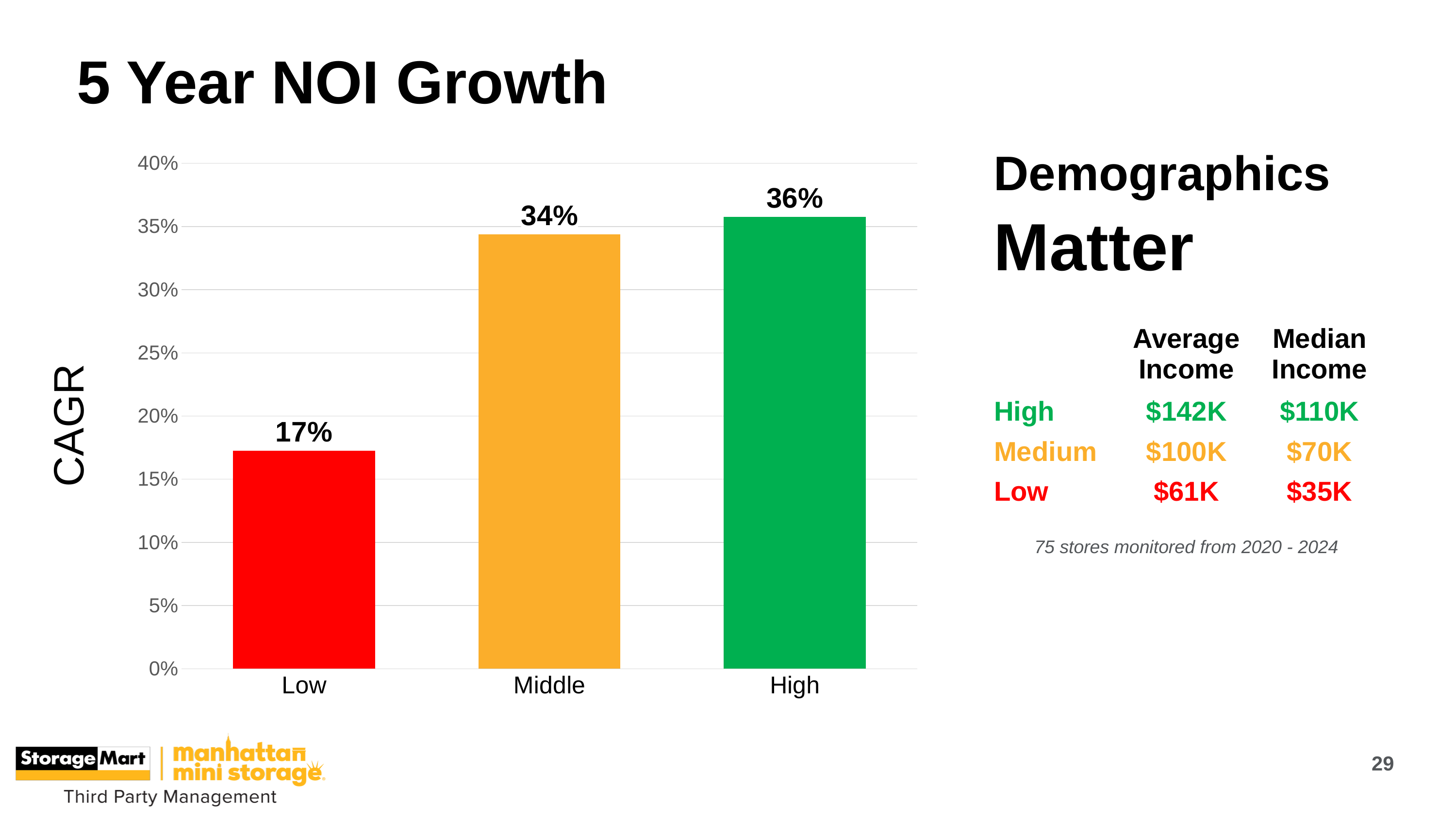
What is the CAGR value for the Middle category? 34% What is the CAGR value for the Low category? 17% Which category has the lowest CAGR? Low What is the CAGR value for the High category? 36% Which has a larger CAGR, Low or Middle? Middle What is the difference between the CAGR for High and the CAGR for Low? 19% What is the difference between the CAGR for Middle and the CAGR for Low? 17% How many categories are shown on the chart? 3 Is the CAGR for Low greater or less than 20%? less Which category has the highest CAGR? High What kind of chart is shown on the slide? Bar chart What is the label on the vertical axis of the chart? CAGR